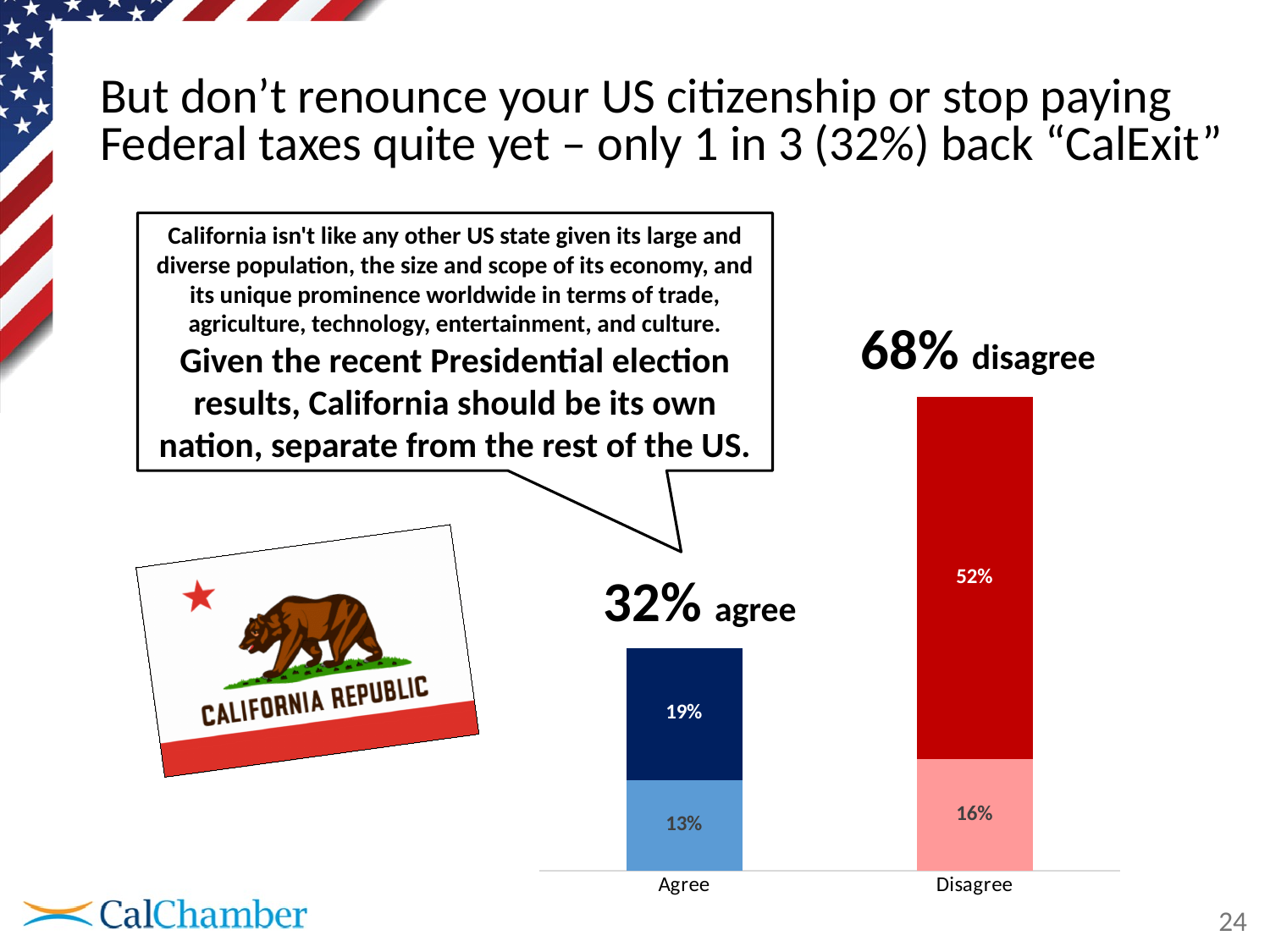
How many categories are shown on the x axis of the chart? 2 Which category has the taller bar, Agree or Disagree? Disagree What is the total of the Agree stacked bar? 32% Which category has the lowest total bar? Agree What is the value of the dark blue segment of the Agree bar? 19% What is the difference between the total for Disagree and the total for Agree? 36% What is the total of the Disagree stacked bar? 68% What kind of chart is shown on the slide? bar chart What is the difference between the dark red segment (52%) and the dark blue segment (19%)? 33% What is the value of the light blue segment of the Agree bar? 13% What is the value of the dark red segment of the Disagree bar? 52% What is the value of the light red segment of the Disagree bar? 16%